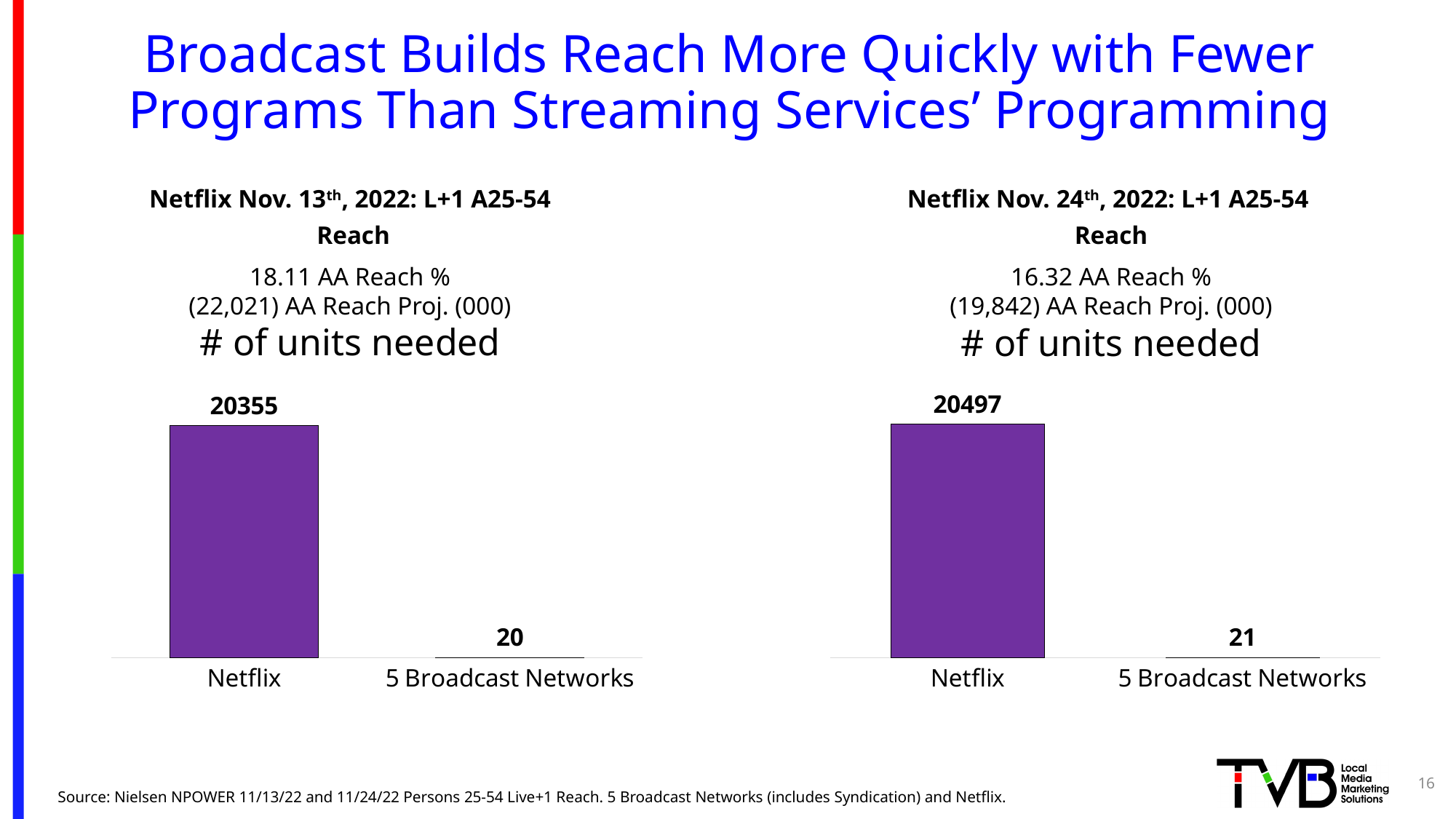
In the right chart (Netflix Nov. 24th, 2022), what is the number of units needed for 5 Broadcast Networks? 21 In the left chart (Netflix Nov. 13th, 2022), which category needs the most units? Netflix In the right chart (Netflix Nov. 24th, 2022), what is the difference in units needed between Netflix and 5 Broadcast Networks? 20476 What type of chart is used on the right (Netflix Nov. 24th, 2022)? Bar chart In the right chart (Netflix Nov. 24th, 2022), which category needs the fewest units? 5 Broadcast Networks How many categories are shown in the left chart (Netflix Nov. 13th, 2022)? 2 What is the AA Reach % stated above the left chart (Netflix Nov. 13th, 2022)? 18.11 AA Reach % In the left chart (Netflix Nov. 13th, 2022), what is the number of units needed for 5 Broadcast Networks? 20 Which is larger: the units needed for Netflix in the left chart (Nov. 13th) or in the right chart (Nov. 24th)? Right chart (Nov. 24th) In the left chart (Netflix Nov. 13th, 2022), what is the difference in units needed between Netflix and 5 Broadcast Networks? 20335 In the right chart (Netflix Nov. 24th, 2022), what is the number of units needed for Netflix? 20497 In the left chart (Netflix Nov. 13th, 2022), what is the number of units needed for Netflix? 20355